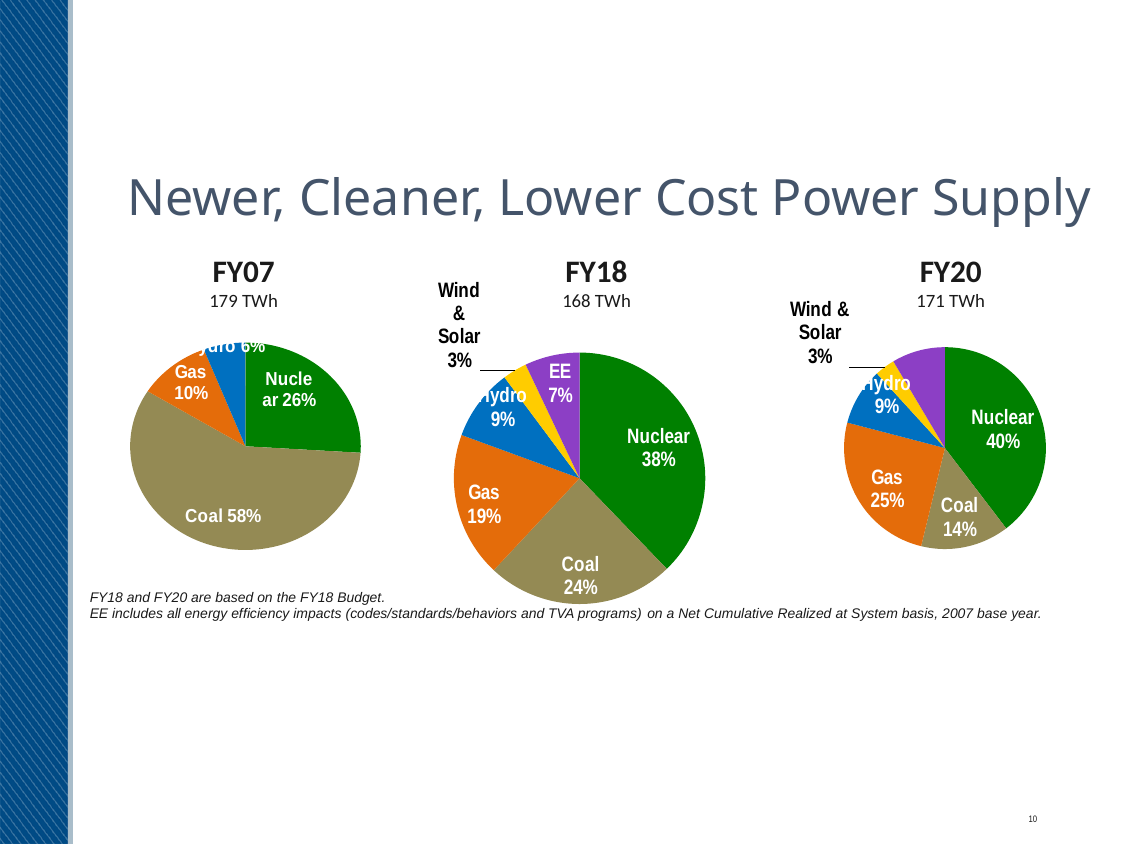
What kind of chart is used for FY07, FY18 and FY20? Pie chart In the FY18 chart, which labeled source has the smallest share? Wind & Solar In the FY18 chart, what share is labeled EE? 7% How many labeled slices does the FY18 pie chart have? 6 In the FY07 chart, which labeled source has the largest share? Coal In the FY20 chart, what share of the power supply is Gas? 25% In the FY07 chart, what share of the power supply is Coal? 58% Which is larger in the FY20 chart, the Gas share or the Coal share? Gas In the FY20 chart, which labeled source has the largest share? Nuclear What is the difference between the Coal share in FY07 and the Coal share in FY18? 34 percentage points In the FY18 chart, what share of the power supply is Nuclear? 38% What total generation in TWh is shown under the FY18 chart title? 168 TWh